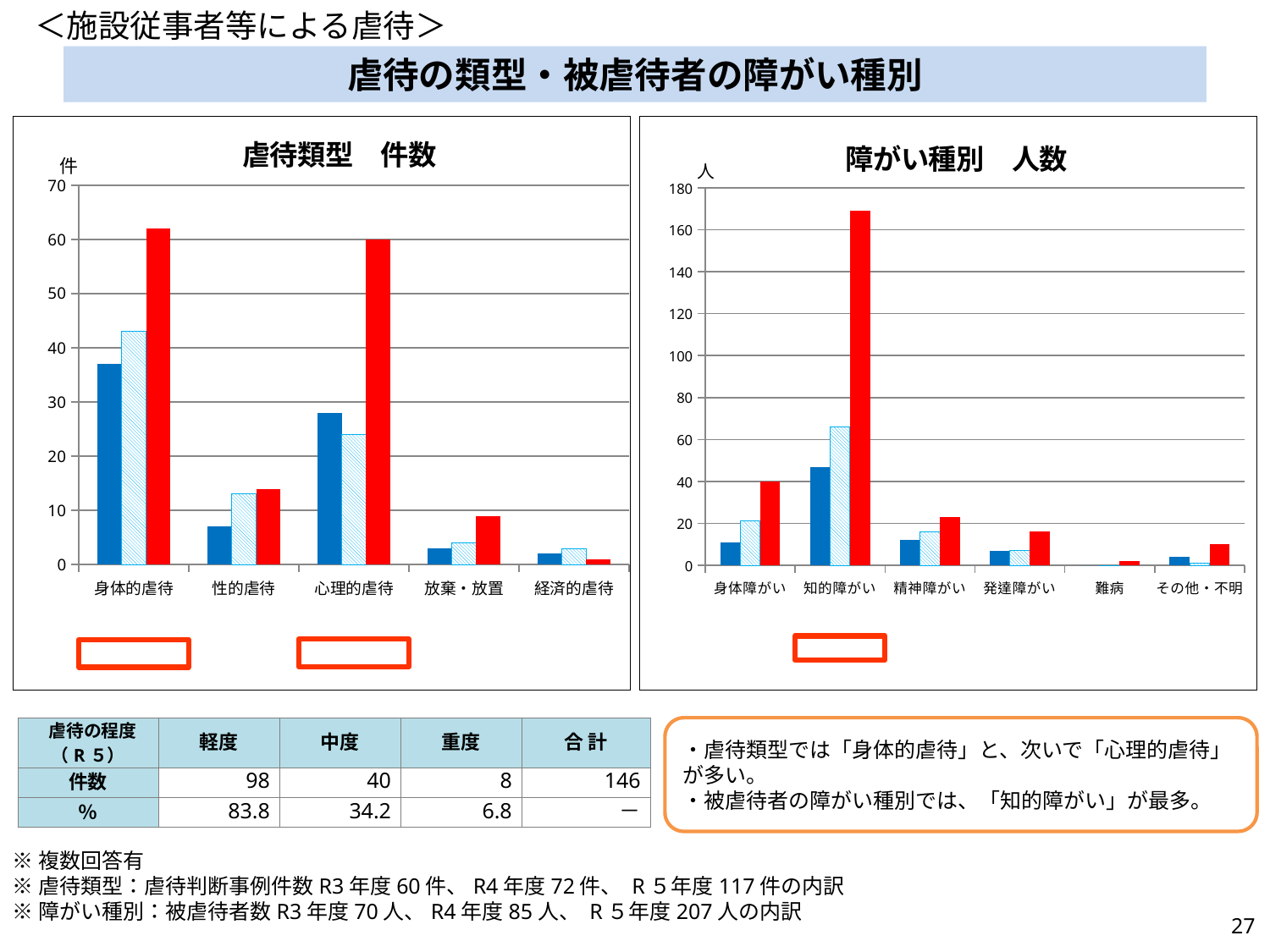
What kind of chart is the left chart titled 虐待類型 件数? bar chart In the right chart (障がい種別 人数), is the red bar for 精神障がい greater or less than 40? less What unit label is shown at the top of the y axis of the left chart (虐待類型 件数)? 件 In the left chart (虐待類型 件数), is the red bar for 身体的虐待 greater or less than 50? greater In the left chart (虐待類型 件数), how many categories are shown on the x axis? 5 In the left chart (虐待類型 件数), which category has the lowest bars overall? 経済的虐待 In the right chart (障がい種別 人数), which is larger: the red bar for 身体障がい or the red bar for 精神障がい? 身体障がい In the left chart (虐待類型 件数), which is larger: the red bar for 身体的虐待 or the red bar for 性的虐待? 身体的虐待 In the left chart (虐待類型 件数), is the red bar for 性的虐待 greater or less than 20? less In the right chart (障がい種別 人数), how many categories are shown on the x axis? 6 In the right chart (障がい種別 人数), which category has the tallest bar? 知的障がい